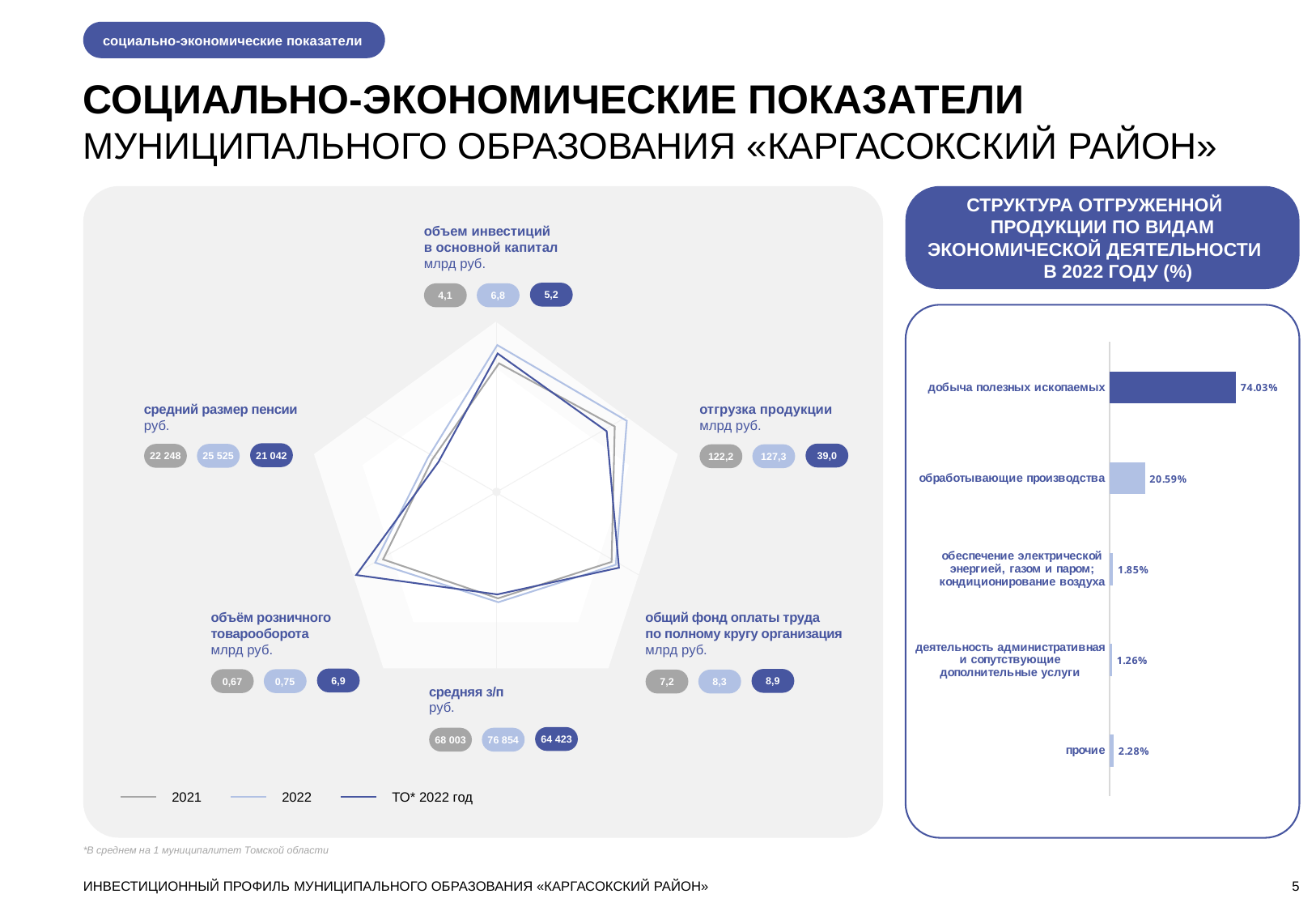
How many categories are shown in the bar chart on the right? 5 In the bar chart on the right, which category has the highest value? добыча полезных ископаемых In the bar chart on the right, which category has the lowest value? деятельность административная и сопутствующие дополнительные услуги In the radar chart on the left, what is the 2021 value for 'средняя з/п' (руб.)? 68 003 What kind of chart is the chart on the right, titled 'СТРУКТУРА ОТГРУЖЕННОЙ ПРОДУКЦИИ ПО ВИДАМ ЭКОНОМИЧЕСКОЙ ДЕЯТЕЛЬНОСТИ В 2022 ГОДУ (%)'? Bar chart What kind of chart is the chart on the left of the slide? Radar chart How many series does the legend of the radar chart on the left list? 3 In the bar chart on the right, what is the difference between 'добыча полезных ископаемых' and 'обрабатывающие производства'? 53.44% In the radar chart on the left, what is the 2022 value for 'отгрузка продукции' (млрд руб.)? 127,3 In the bar chart on the right, what is the value for 'добыча полезных ископаемых'? 74.03% In the bar chart on the right, what is the value for 'обрабатывающие производства'? 20.59% In the bar chart on the right, which is larger: 'прочие' or 'обеспечение электрической энергией, газом и паром; кондиционирование воздуха'? прочие